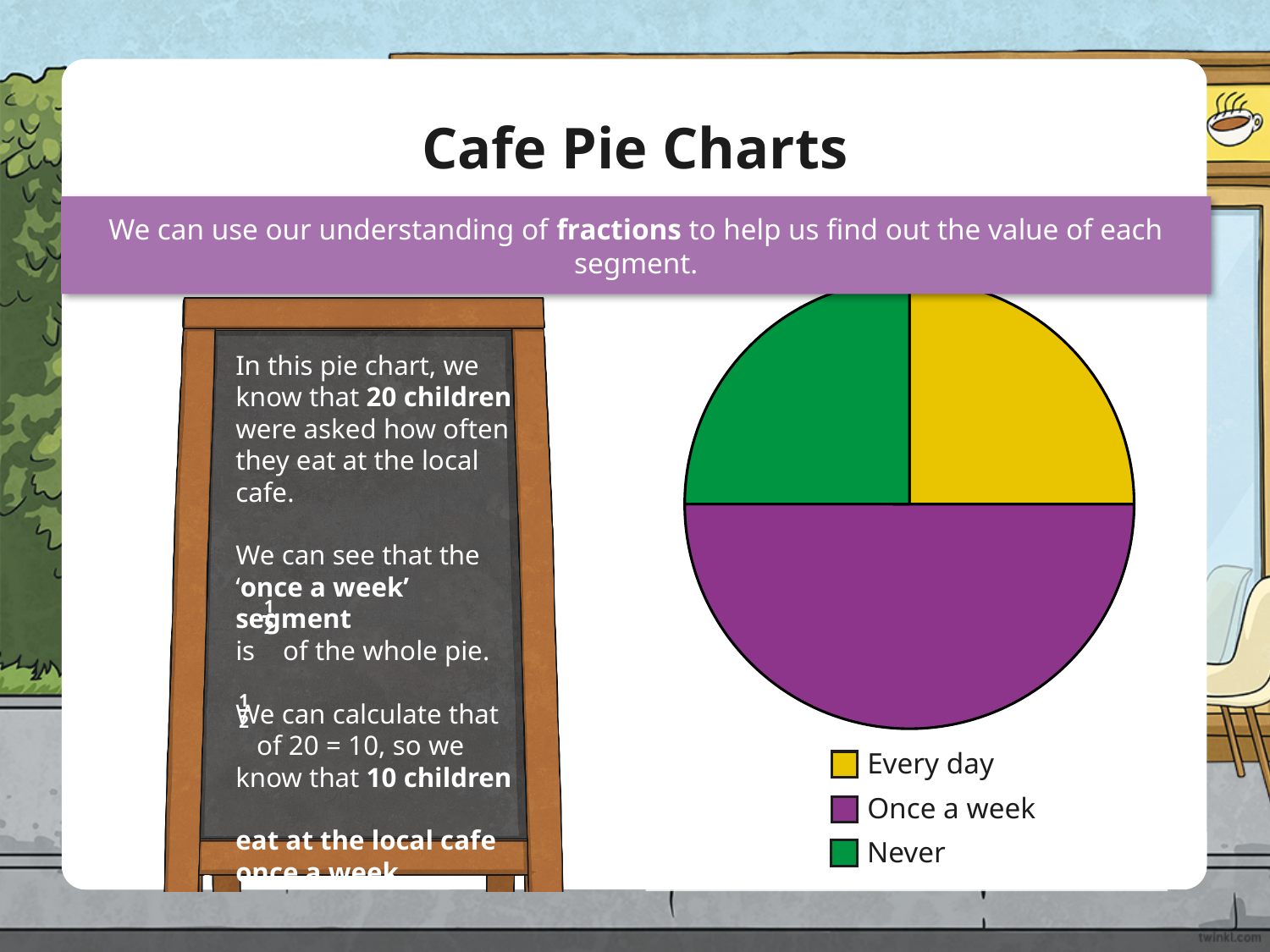
What is the title of the slide containing the pie chart? Cafe Pie Charts What kind of chart is shown on the slide? pie chart According to the slide, how many children eat at the local cafe once a week? 10 According to the slide, how many children were asked how often they eat at the local cafe? 20 How many segments does the pie chart have? 3 What fraction of the whole pie is the 'Once a week' segment? 1/2 Which is larger in the pie chart, the 'Once a week' segment or the 'Never' segment? Once a week Which segment of the pie chart is the largest? Once a week How many entries does the legend of the pie chart list? 3 Which is larger in the pie chart, the 'Once a week' segment or the 'Every day' segment? Once a week What colour represents 'Never' in the pie chart? green